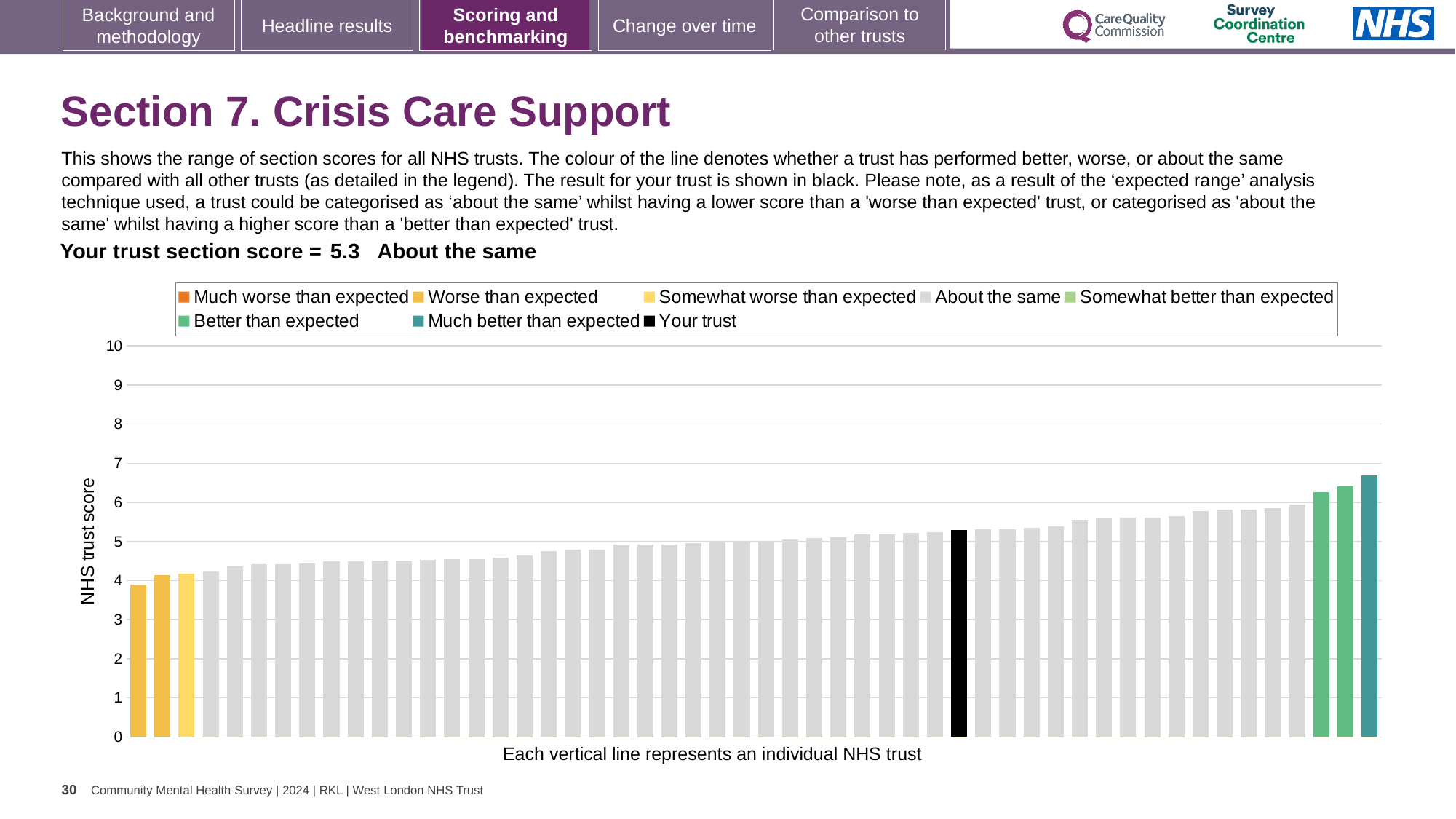
What colour is used for the bar representing your trust? black Is the value of the highest bar in the chart greater or less than 6? greater Is the value for your trust (the black bar) greater or less than 6? less Which legend category does the highest bar in the chart belong to? Much better than expected What is the label on the vertical axis of the chart? NHS trust score How many bars are coloured as 'Much better than expected'? 1 What is the section score for your trust shown on the slide? 5.3 Do the bar values rise or fall from left to right along the x axis? rise How many entries does the chart legend list? 8 Is the value for your trust (the black bar) greater or less than 5? greater What kind of chart is shown on the slide? bar chart